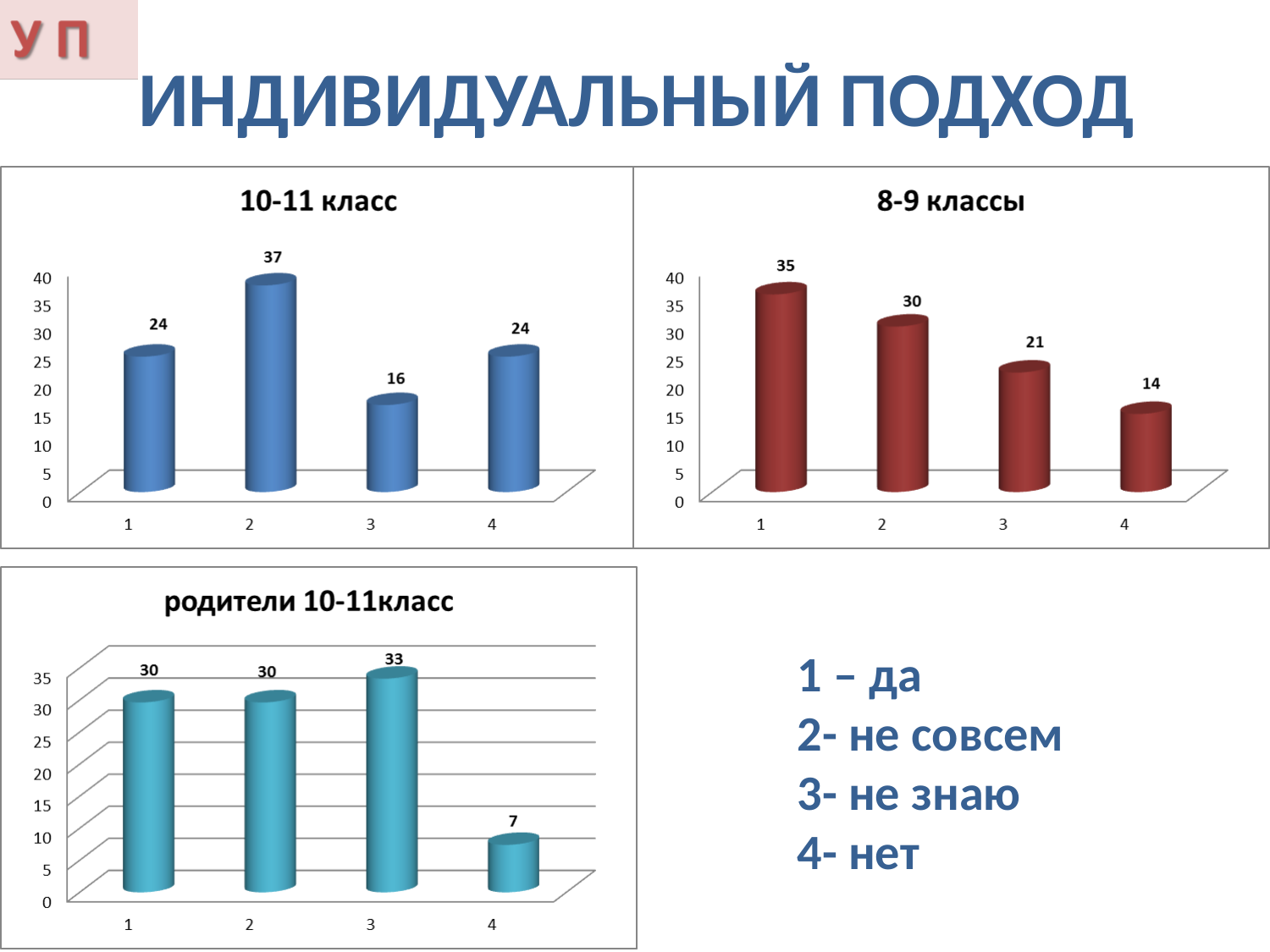
In the "8-9 классы" chart, what is the difference between the values for category 1 and category 4? 21 What kind of chart is the "10-11 класс" chart? bar chart In the "10-11 класс" chart, what is the difference between the values for category 2 and category 3? 21 In the "8-9 классы" chart, do the values rise or fall from category 1 to category 4? fall In the "родители 10-11класс" chart, how many categories are shown on the x axis? 4 In the "родители 10-11класс" chart, what is the value for category 4? 7 In the "10-11 класс" chart, which category has the lowest value? 3 In the "10-11 класс" chart, what is the value for category 2? 37 In the "8-9 классы" chart, what is the value for category 1? 35 In the "родители 10-11класс" chart, which category has the highest value? 3 In the "8-9 классы" chart, which category has the highest value? 1 Which is larger: the value for category 3 in the "10-11 класс" chart or the value for category 3 in the "8-9 классы" chart? 8-9 классы